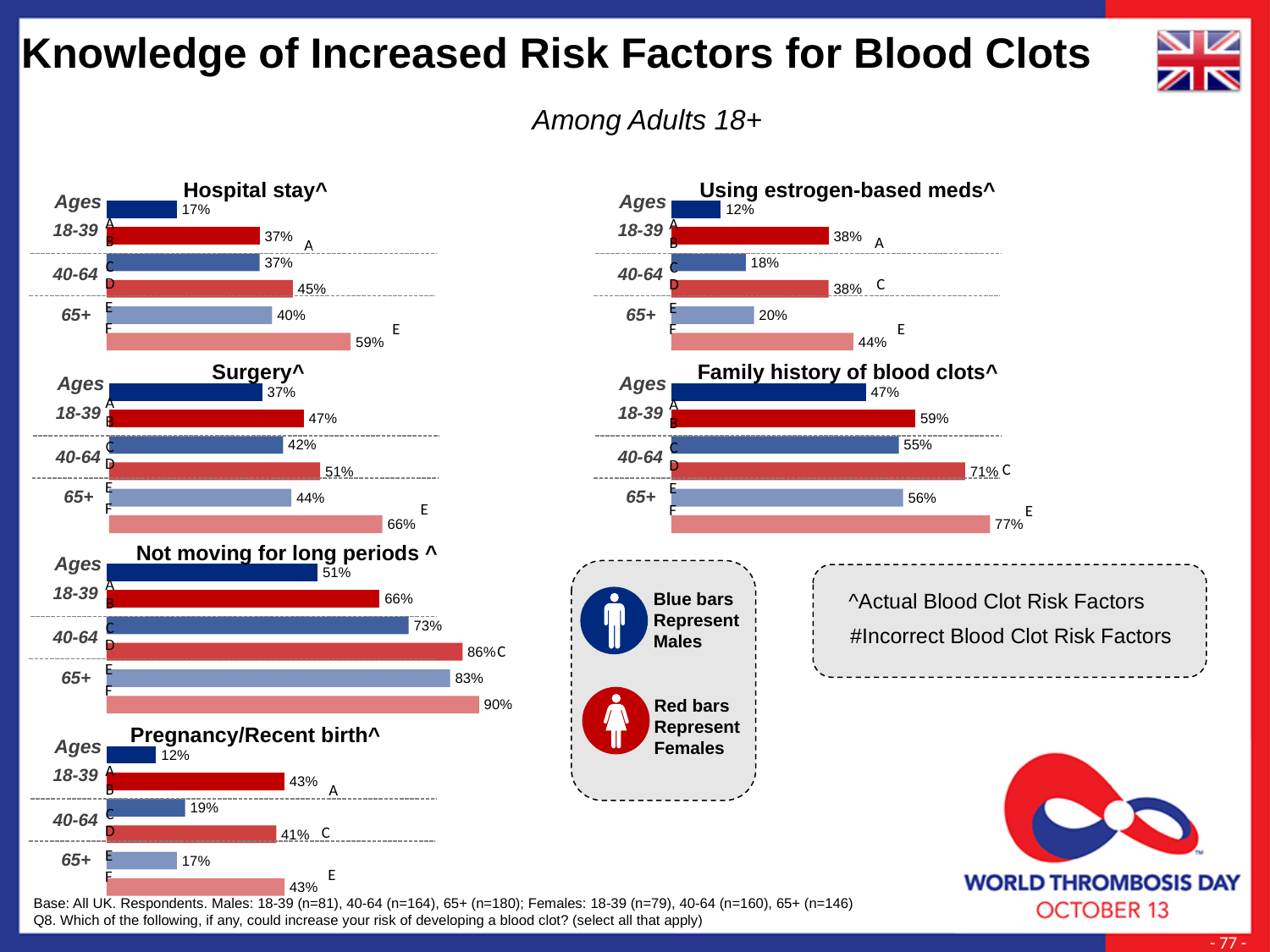
In the 'Family history of blood clots' chart, do the male values rise or fall as age increases from 18-39 to 65+? Rise In the 'Not moving for long periods' chart, which group has the highest value? Females 65+ In the 'Hospital stay' chart, what percentage of females aged 65+ identified hospital stay as a risk factor? 59% How many charts are shown on the slide? 6 In the 'Using estrogen-based meds' chart, what is the value for females aged 65+? 44% According to the legend, what do the red bars represent? Females In the 'Surgery' chart, what is the difference between the female 65+ value and the male 65+ value? 22% In the 'Pregnancy/Recent birth' chart, which is larger: the value for females aged 18-39 or the value for females aged 40-64? Females aged 18-39 In the 'Pregnancy/Recent birth' chart, which group has the lowest value? Males 18-39 In the 'Family history of blood clots' chart, what is the difference between the female 40-64 value and the male 40-64 value? 16% In the 'Hospital stay' chart, what is the value for males aged 18-39? 17% In the 'Not moving for long periods' chart, what is the value for males aged 40-64? 73%